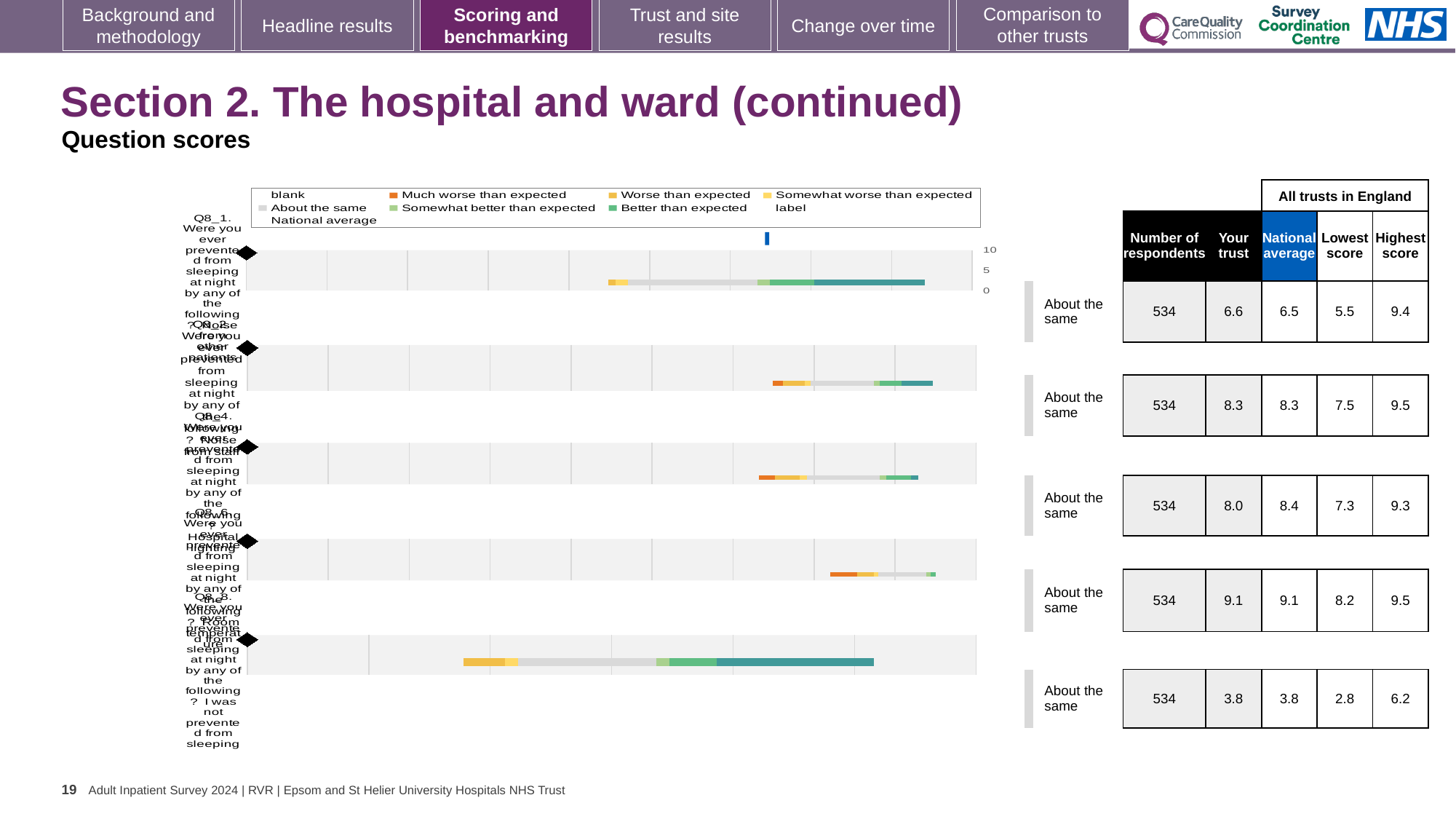
What is the number of respondents shown for each question row? 534 What is the highest score across all trusts in England for the last question row (Q8_8)? 6.2 What benchmark category is shown for every question row in the chart? About the same How many question rows (bars) are plotted in the chart? 5 Which question row has the lowest 'Your trust' score? Q8_8 What kind of chart is shown on the slide? bar chart What is the national average for the first question row (Q8_1)? 6.5 What is the 'Your trust' score for the last question row (Q8_8)? 3.8 Is the 'Your trust' score for the fourth question row (Q8_6) larger than the national average for that row? No, they are equal (9.1) What is the 'Your trust' score for the first question row (Q8_1)? 6.6 Which question row has the highest 'Your trust' score? Q8_6 What is the difference between the 'Your trust' score and the national average for the third question row (Q8_4)? 0.4